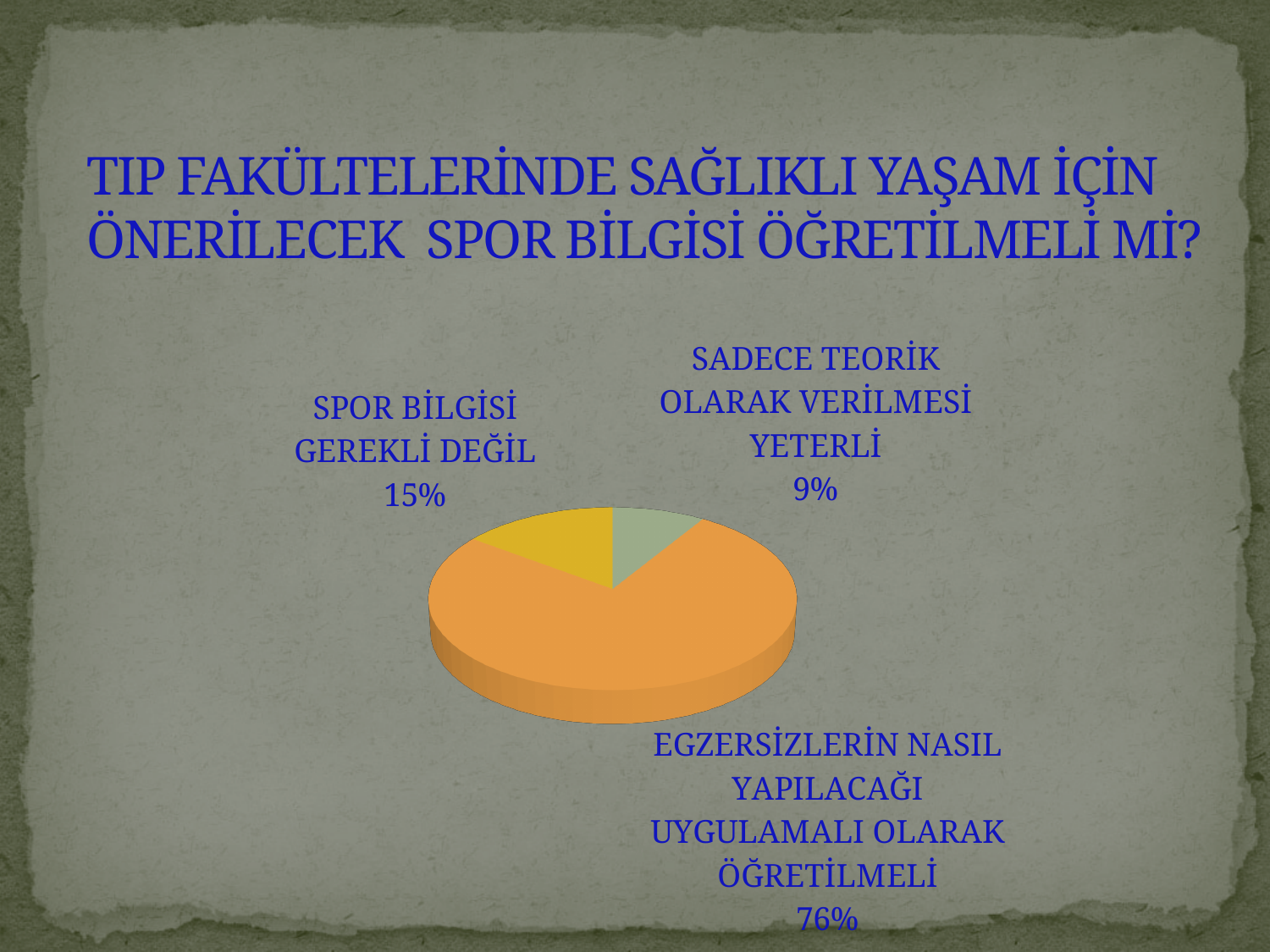
How many slices does the pie chart have? 3 Which is larger: the share for "SPOR BİLGİSİ GEREKLİ DEĞİL" or for "SADECE TEORİK OLARAK VERİLMESİ YETERLİ"? SPOR BİLGİSİ GEREKLİ DEĞİL What share of the pie does "SADECE TEORİK OLARAK VERİLMESİ YETERLİ" have? 9% Which category has the largest slice of the pie? EGZERSİZLERİN NASIL YAPILACAĞI UYGULAMALI OLARAK ÖĞRETİLMELİ Which category has the smallest slice of the pie? SADECE TEORİK OLARAK VERİLMESİ YETERLİ What share of the pie does "SPOR BİLGİSİ GEREKLİ DEĞİL" have? 15% What kind of chart is shown on the slide? pie chart What is the difference in percentage points between "EGZERSİZLERİN NASIL YAPILACAĞI UYGULAMALI OLARAK ÖĞRETİLMELİ" and "SPOR BİLGİSİ GEREKLİ DEĞİL"? 61% What is the difference in percentage points between "SPOR BİLGİSİ GEREKLİ DEĞİL" and "SADECE TEORİK OLARAK VERİLMESİ YETERLİ"? 6% What is the title of the slide containing the pie chart? TIP FAKÜLTELERİNDE SAĞLIKLI YAŞAM İÇİN ÖNERİLECEK SPOR BİLGİSİ ÖĞRETİLMELİ Mİ? What share of the pie does "EGZERSİZLERİN NASIL YAPILACAĞI UYGULAMALI OLARAK ÖĞRETİLMELİ" have? 76% What colour is the slice for "SPOR BİLGİSİ GEREKLİ DEĞİL"? yellow